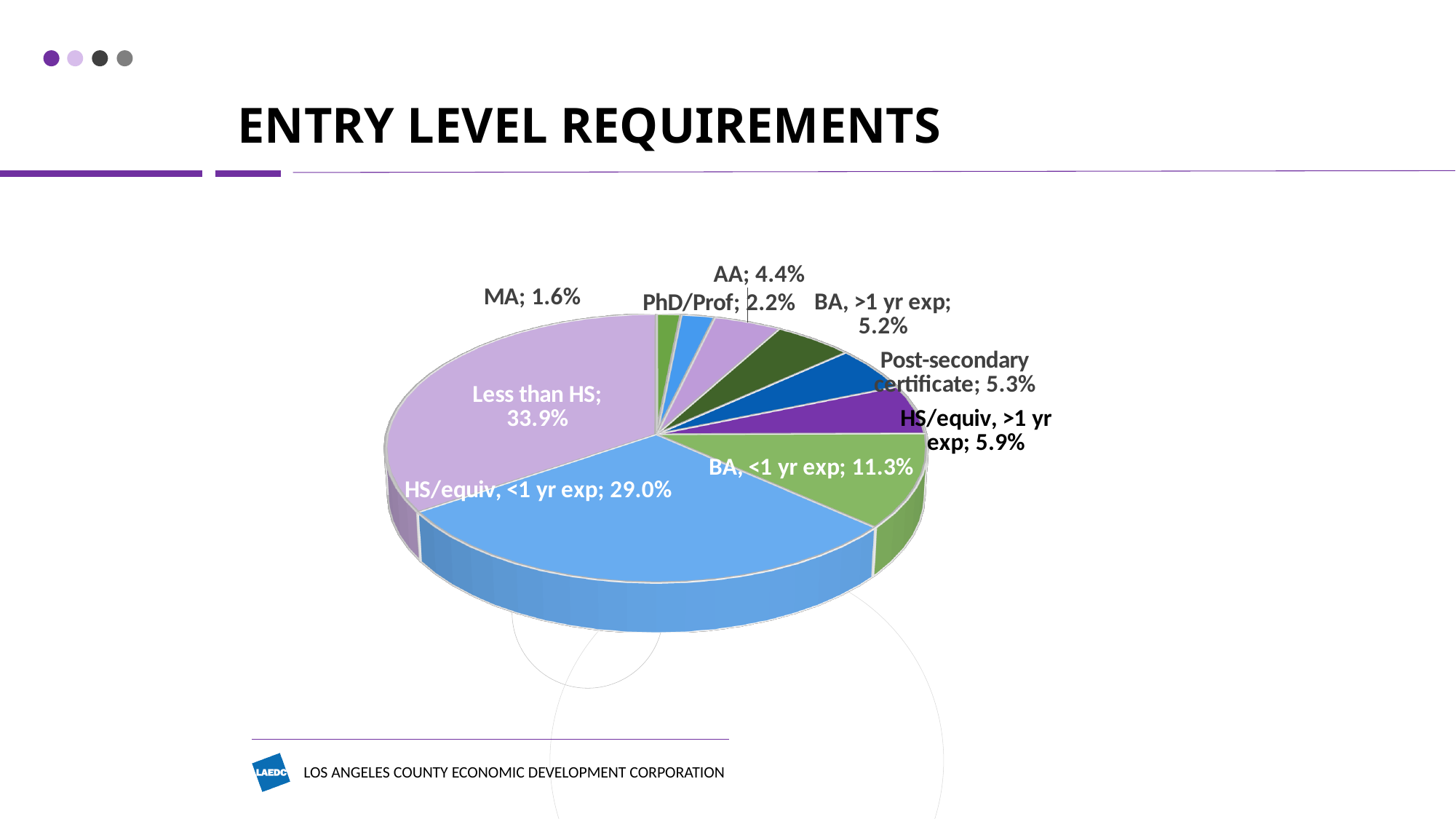
Which is larger, the share for 'AA' or the share for 'PhD/Prof'? AA What kind of chart is shown on the slide? Pie chart What is the value for 'Post-secondary certificate'? 5.3% What is the difference between the shares for 'Less than HS' and 'HS/equiv, <1 yr exp'? 4.9% What is the value for 'BA, <1 yr exp'? 11.3% What share of the pie is labelled 'Less than HS'? 33.9% Which category has the smallest share of the pie? MA Which category has the largest share of the pie? Less than HS What is the title of the slide containing the chart? ENTRY LEVEL REQUIREMENTS What is the value for 'MA'? 1.6% How many slices does the pie chart have? 9 What is the value for 'HS/equiv, <1 yr exp'? 29.0%